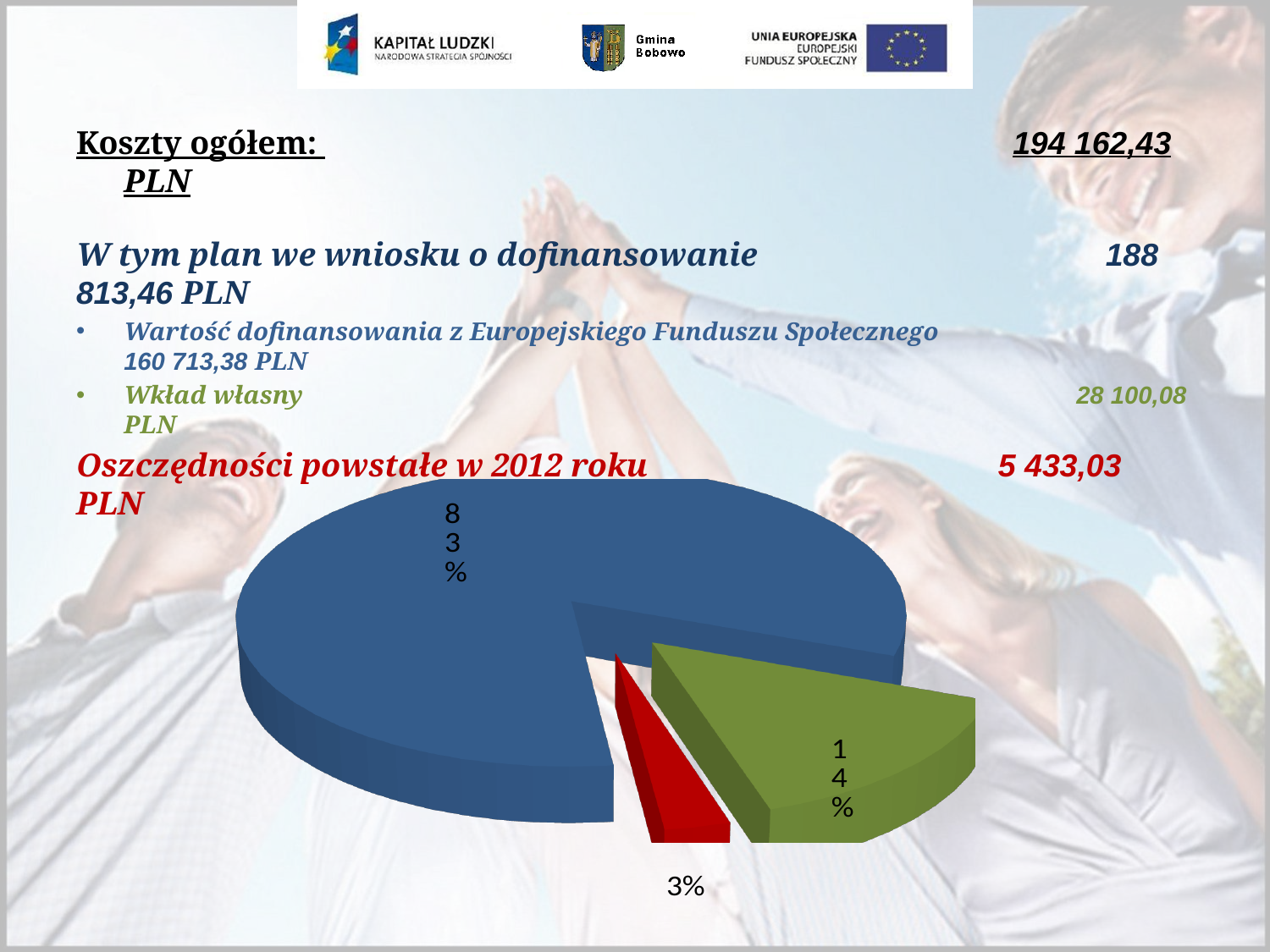
What percentage is shown on the red slice of the pie chart? 3% Which colour slice is the largest in the pie chart? blue By how many percentage points does the blue slice exceed the green slice? 69 What kind of chart is shown on the slide? pie chart What percentage is shown on the blue slice of the pie chart? 83% What percentage is shown on the green slice of the pie chart? 14% Which is larger in the pie chart, the green slice or the red slice? green What is the combined share of the green and red slices? 17% How many slices does the pie chart have? 3 Which colour slice is the smallest in the pie chart? red By how many percentage points does the green slice exceed the red slice? 11 Does the pie chart have a legend? No